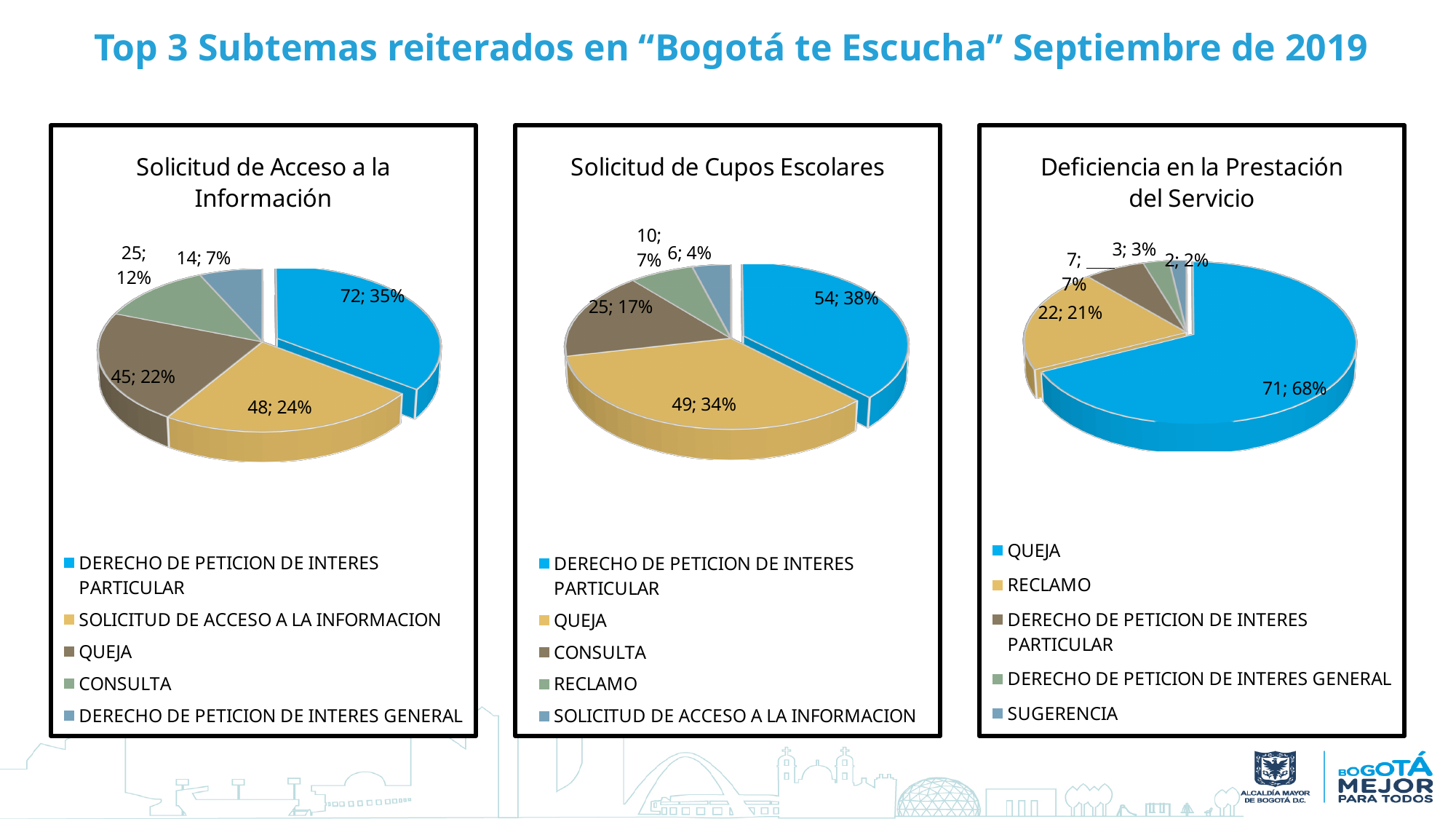
In the "Solicitud de Cupos Escolares" chart, how many categories does the legend list? 5 What type of chart is used in the "Deficiencia en la Prestación del Servicio" panel? Pie chart In the "Solicitud de Acceso a la Información" chart, what is the value shown for QUEJA? 45; 22% In the "Solicitud de Acceso a la Información" chart, what share of the pie does CONSULTA represent? 12% In the "Solicitud de Acceso a la Información" chart, what is the difference in count between DERECHO DE PETICION DE INTERES PARTICULAR and SOLICITUD DE ACCESO A LA INFORMACION? 24 In the "Solicitud de Cupos Escolares" chart, which category has the smallest slice? SOLICITUD DE ACCESO A LA INFORMACION In the "Solicitud de Acceso a la Información" chart, which category has the largest slice? DERECHO DE PETICION DE INTERES PARTICULAR In the "Deficiencia en la Prestación del Servicio" chart, what share of the pie does QUEJA represent? 68% In the "Deficiencia en la Prestación del Servicio" chart, what is the value shown for RECLAMO? 22; 21% In the "Solicitud de Cupos Escolares" chart, which is larger: QUEJA or RECLAMO? QUEJA In the "Deficiencia en la Prestación del Servicio" chart, what is the difference in count between QUEJA and RECLAMO? 49 In the "Solicitud de Cupos Escolares" chart, what is the value shown for CONSULTA? 25; 17%